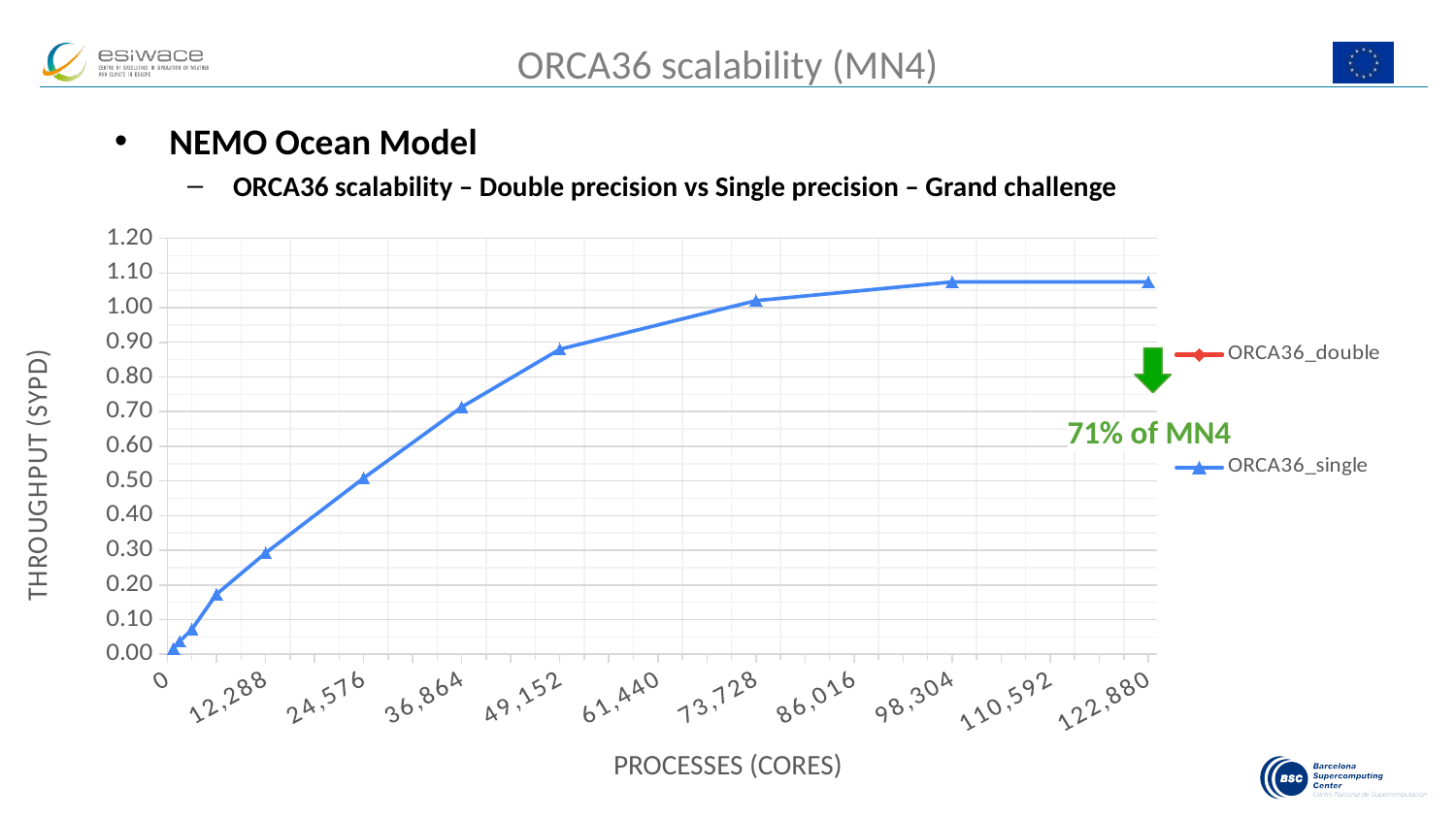
What kind of chart is shown on the slide? Line chart Is the ORCA36_single throughput at 49,152 processes greater or less than 0.80? greater Is the ORCA36_single throughput at 24,576 processes greater or less than 0.40? greater Is the ORCA36_single throughput at 122,880 processes greater or less than 1.00? greater How many series does the chart legend list? 2 What is the title of the vertical axis of the chart? THROUGHPUT (SYPD) Which series are listed in the chart legend? ORCA36_double and ORCA36_single Does the ORCA36_single throughput rise or fall as the number of processes increases? Rises Which has the higher ORCA36_single throughput: 24,576 processes or 36,864 processes? 36,864 processes